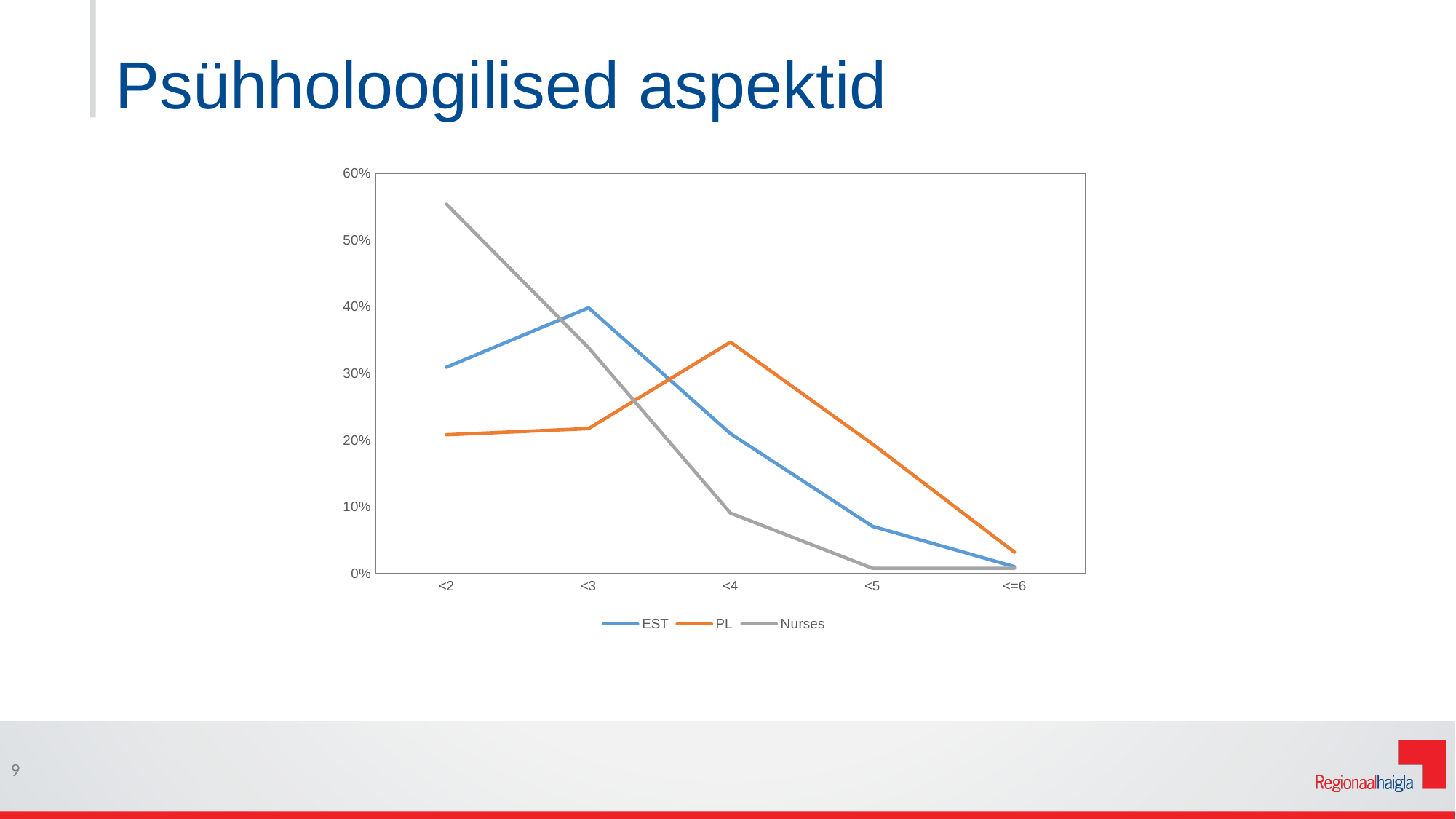
Is the value for EST at <5 greater or less than 10%? less How many series does the legend list? 3 Do the values of the Nurses series rise or fall from <2 to <=6? fall What kind of chart is shown on the slide? line chart At <4, which series has the larger value, PL or Nurses? PL Which series are listed in the legend? EST, PL, Nurses At which category does the PL series reach its highest value? <4 At which category does the Nurses series reach its highest value? <2 How many categories are shown on the x axis? 5 Is the value for Nurses at <2 greater or less than 50%? greater At which category does the EST series reach its highest value? <3 Is the value for PL at <2 greater or less than 30%? less